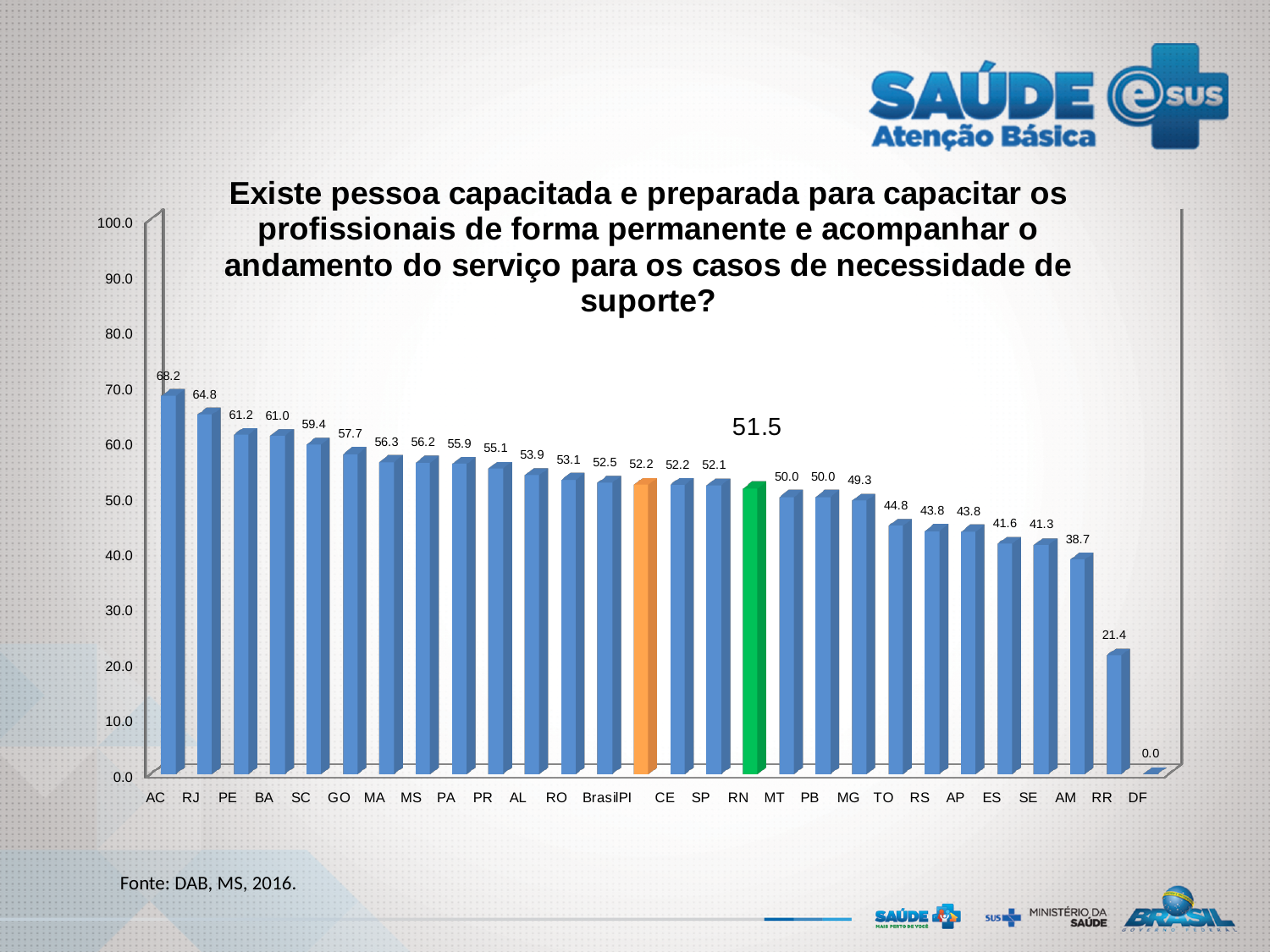
Which category has the lowest value? DF Is the value for RR greater or less than 30.0? less What is the value for RR? 21.4 Do the values rise or fall from left to right along the x axis? fall What is the value for AC? 68.2 How many categories are shown on the x axis? 28 Which is larger, the value for TO or the value for AM? TO What is the difference between the values for AC and RJ? 3.4 Which category has the highest value? AC What kind of chart is shown on the slide? bar chart What is the value for SC? 59.4 What is the value for RN? 51.5